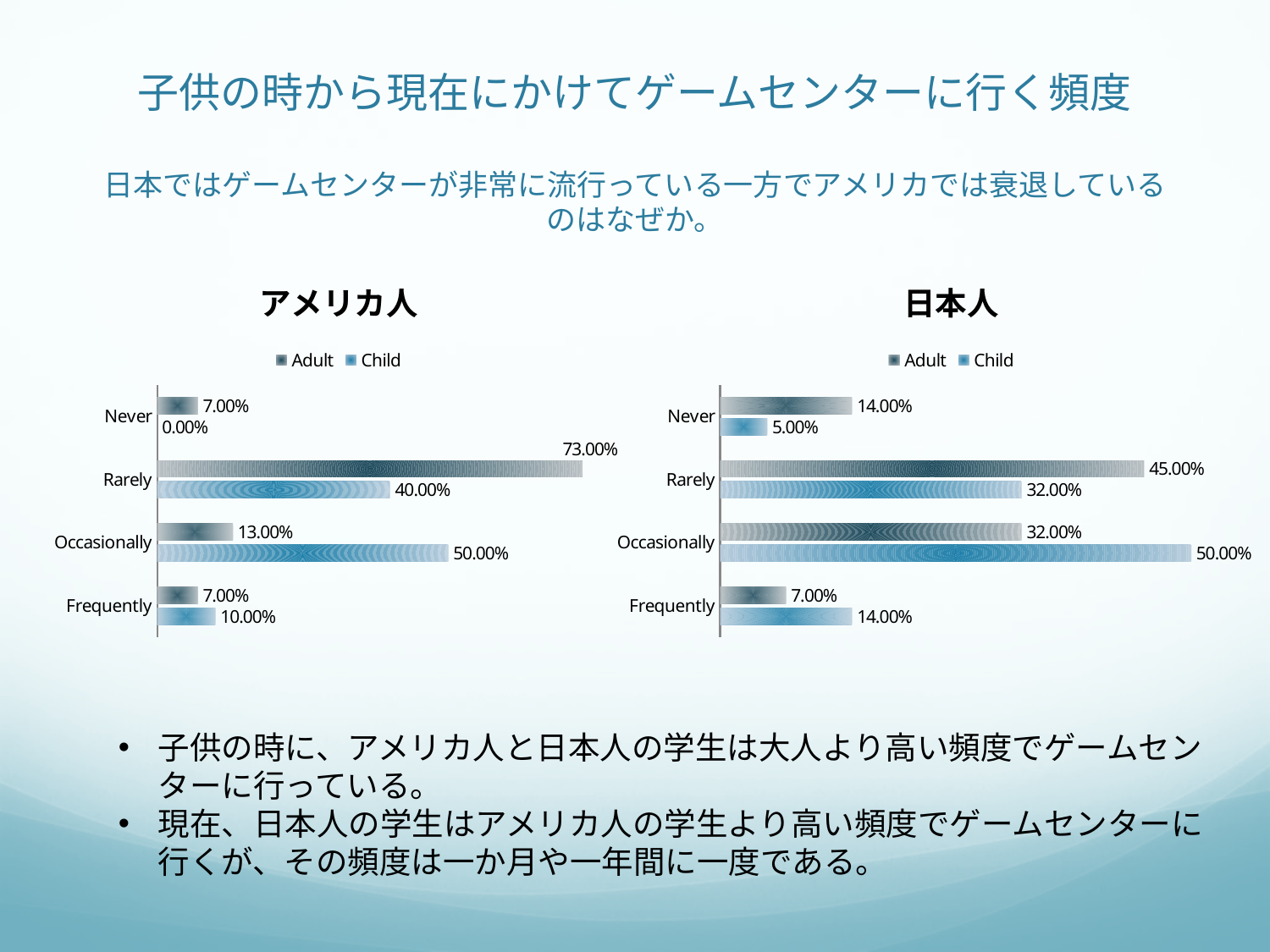
How many series does the legend of the アメリカ人 chart list? 2 What are the two series named in the legend of the 日本人 chart? Adult and Child What kind of chart is the 日本人 chart? Bar chart How many categories are shown in the 日本人 chart? 4 In the アメリカ人 chart, what is the Adult value for Rarely? 73.00% In the 日本人 chart, what is the Adult value for Never? 14.00% In the 日本人 chart, what is the difference between the Adult and Child values for Rarely? 13.00% In the 日本人 chart, which category has the lowest Child value? Never In the アメリカ人 chart, which is larger for Occasionally: the Adult value or the Child value? Child In the 日本人 chart, what is the Child value for Frequently? 14.00% In the アメリカ人 chart, which category has the highest Adult value? Rarely In the アメリカ人 chart, what is the Child value for Occasionally? 50.00%